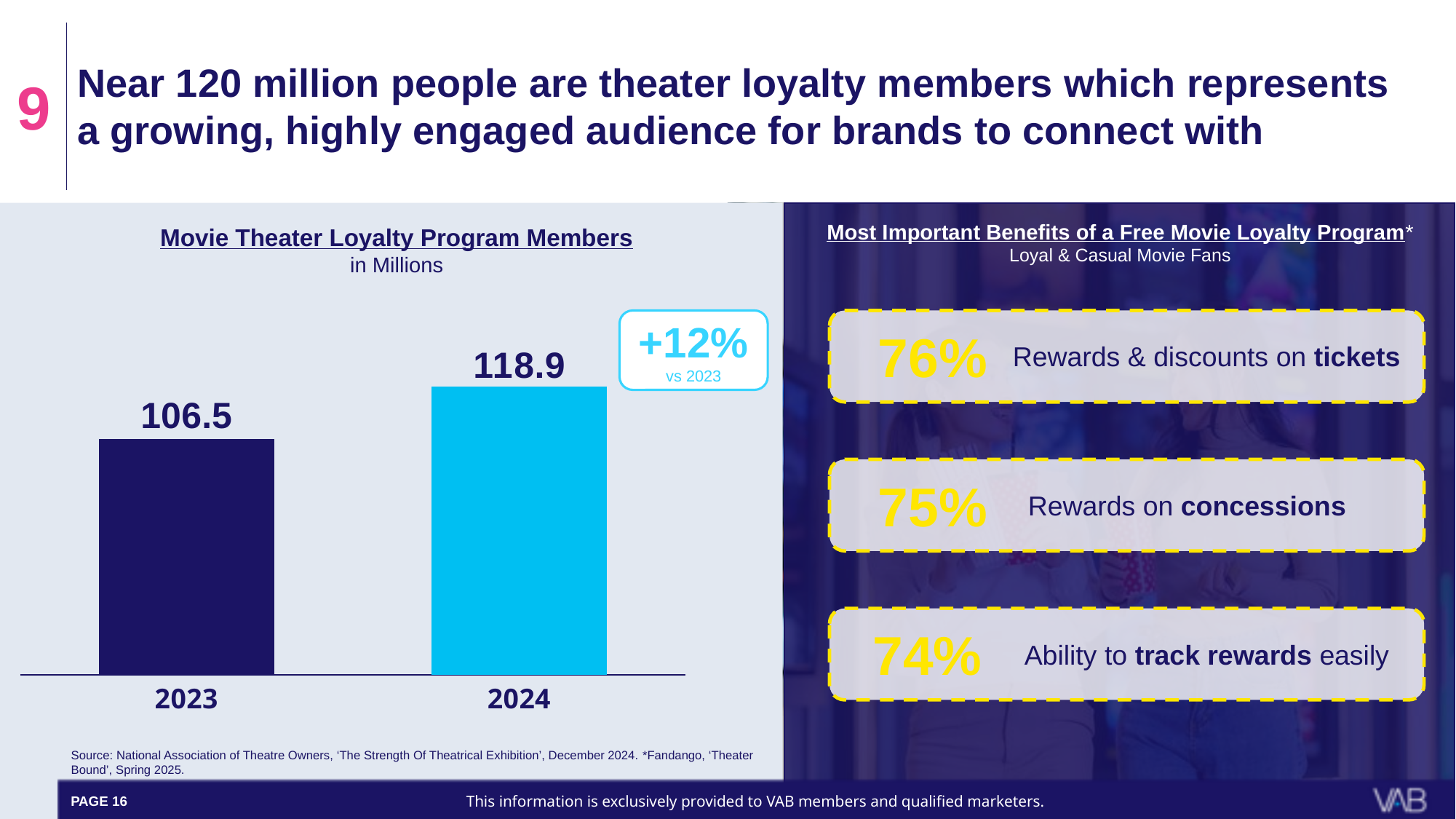
In the Movie Theater Loyalty Program Members chart, which year has the lower value? 2023 What percentage change vs 2023 is shown in the callout on the Movie Theater Loyalty Program Members chart? +12% What is the difference between the 2024 and 2023 values in the Movie Theater Loyalty Program Members chart? 12.4 Do the values in the Movie Theater Loyalty Program Members chart rise or fall from 2023 to 2024? rise What is the value for 2023 in the Movie Theater Loyalty Program Members chart? 106.5 How many bars are shown in the Movie Theater Loyalty Program Members chart? 2 In the Movie Theater Loyalty Program Members chart, is the value for 2023 larger or smaller than the value for 2024? smaller In the Movie Theater Loyalty Program Members chart, which year has the higher value? 2024 What kind of chart is the Movie Theater Loyalty Program Members chart? bar chart In what unit are the values in the Movie Theater Loyalty Program Members chart expressed? Millions What is the value for 2024 in the Movie Theater Loyalty Program Members chart? 118.9